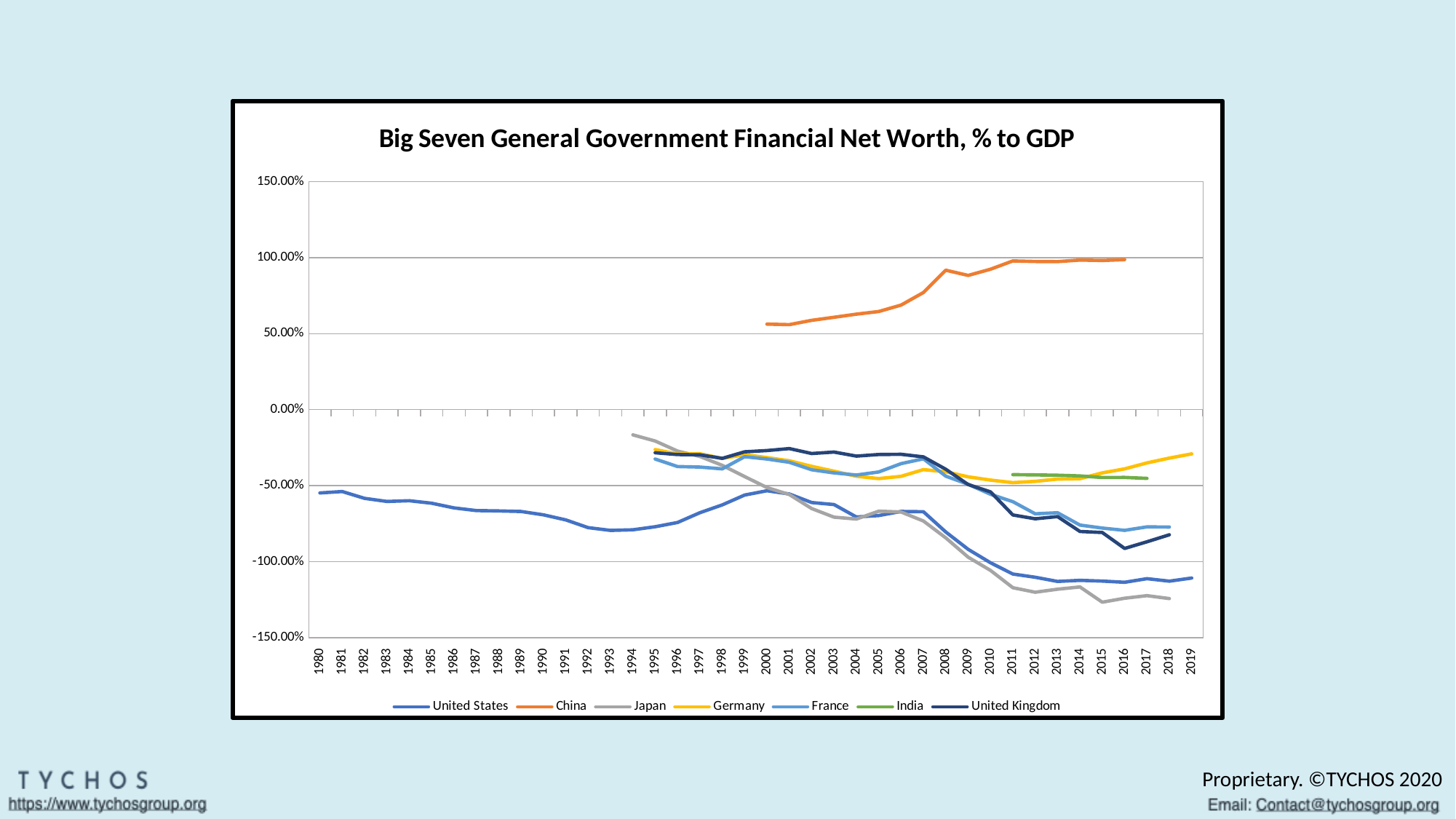
How many series does the legend list? 7 In 2016, which is larger: the value for France or the value for the United Kingdom? France Does the line for Japan rise or fall from 1994 to 2018? fall Is the value for China in 2016 greater or less than 50.00%? greater Which country's line has the highest values on the chart? China Is the value for the United States in 2019 greater or less than -100.00%? less Is the value for Germany in 2019 greater or less than -50.00%? greater Does the line for China rise or fall from 2000 to 2016? rise What kind of chart is shown on the slide? line chart What is the title of the chart? Big Seven General Government Financial Net Worth, % to GDP Which country has the lowest value in 2018? Japan